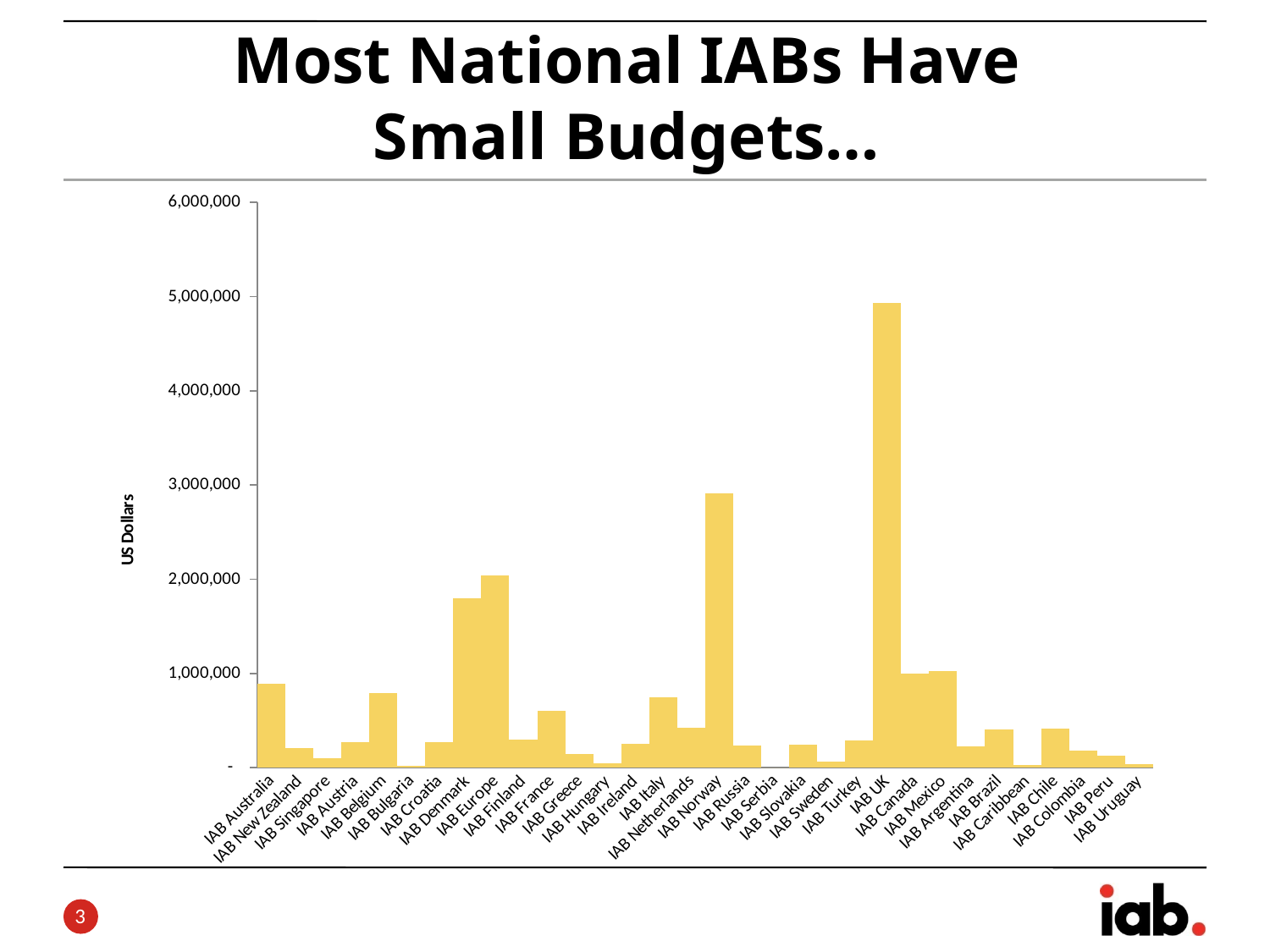
Which has the larger budget, IAB Norway or IAB Denmark? IAB Norway Is the value for IAB Italy greater or less than 1,000,000? less What kind of chart is shown on the slide? bar chart What is the label on the vertical axis of the chart? US Dollars Is the value for IAB Norway greater or less than 2,000,000? greater Is the value for IAB Australia greater or less than 1,000,000? less Which has the larger budget, IAB Europe or IAB Denmark? IAB Europe Which national IAB has the highest budget in the chart? IAB UK How many national IABs are shown on the x axis of the chart? 32 Which has the larger budget, IAB Belgium or IAB Austria? IAB Belgium